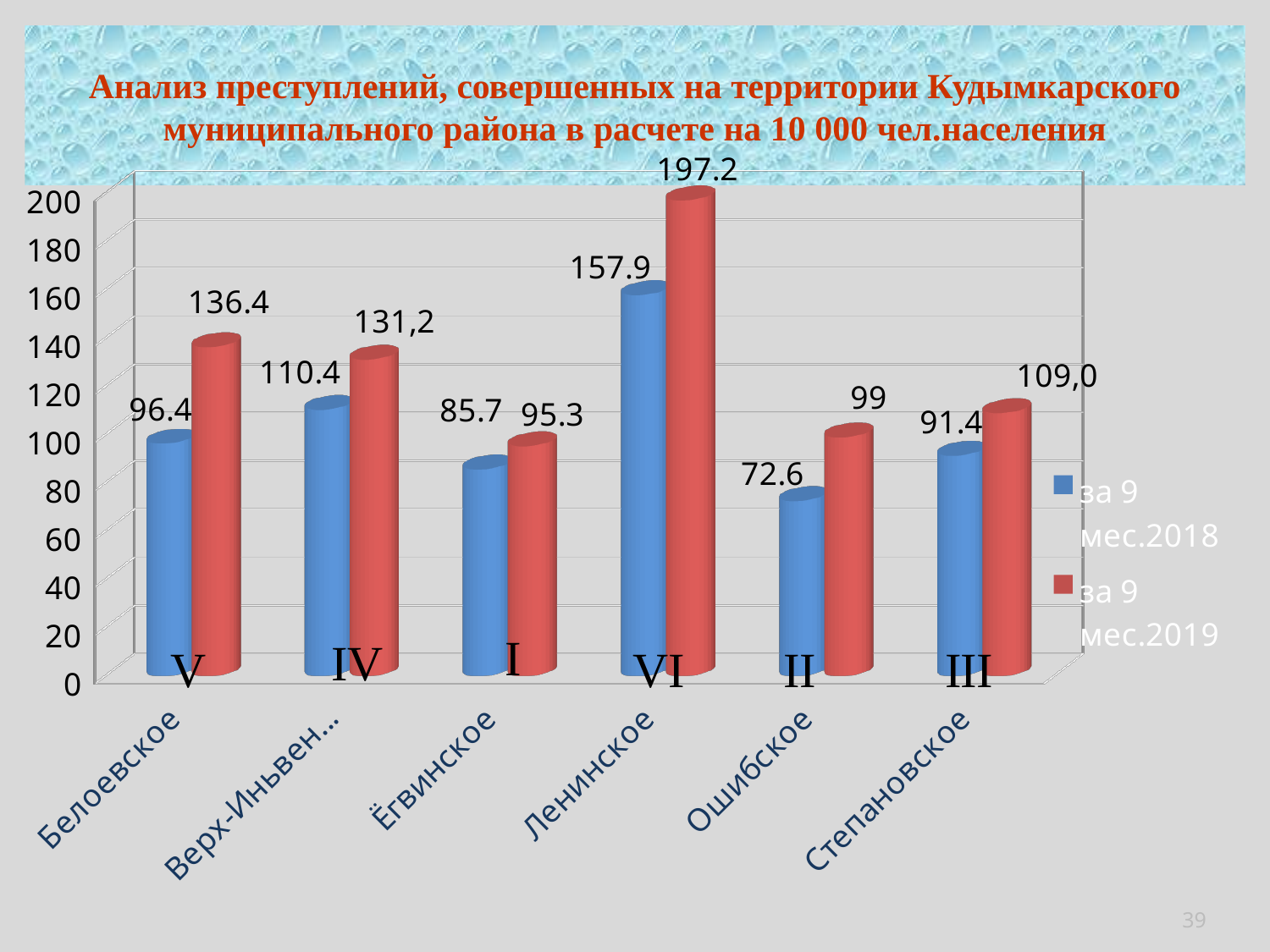
What is the difference between the за 9 мес.2019 and за 9 мес.2018 values for Белоевское? 40 Which category has the lowest value for за 9 мес.2018? Ошибское What is the value for Ошибское for за 9 мес.2018? 72.6 What is the value for Ленинское for за 9 мес.2019? 197.2 Which category has the highest value for за 9 мес.2019? Ленинское What type of chart is shown on the slide? bar chart How many series does the legend list? 2 What is the value for Степановское for за 9 мес.2019? 109,0 Which is larger for Ёгвинское: the за 9 мес.2018 value or the за 9 мес.2019 value? за 9 мес.2019 How many categories (settlements) are shown on the x axis? 6 What is the value for Белоевское for за 9 мес.2019? 136.4 Which series is shown in red? за 9 мес.2019